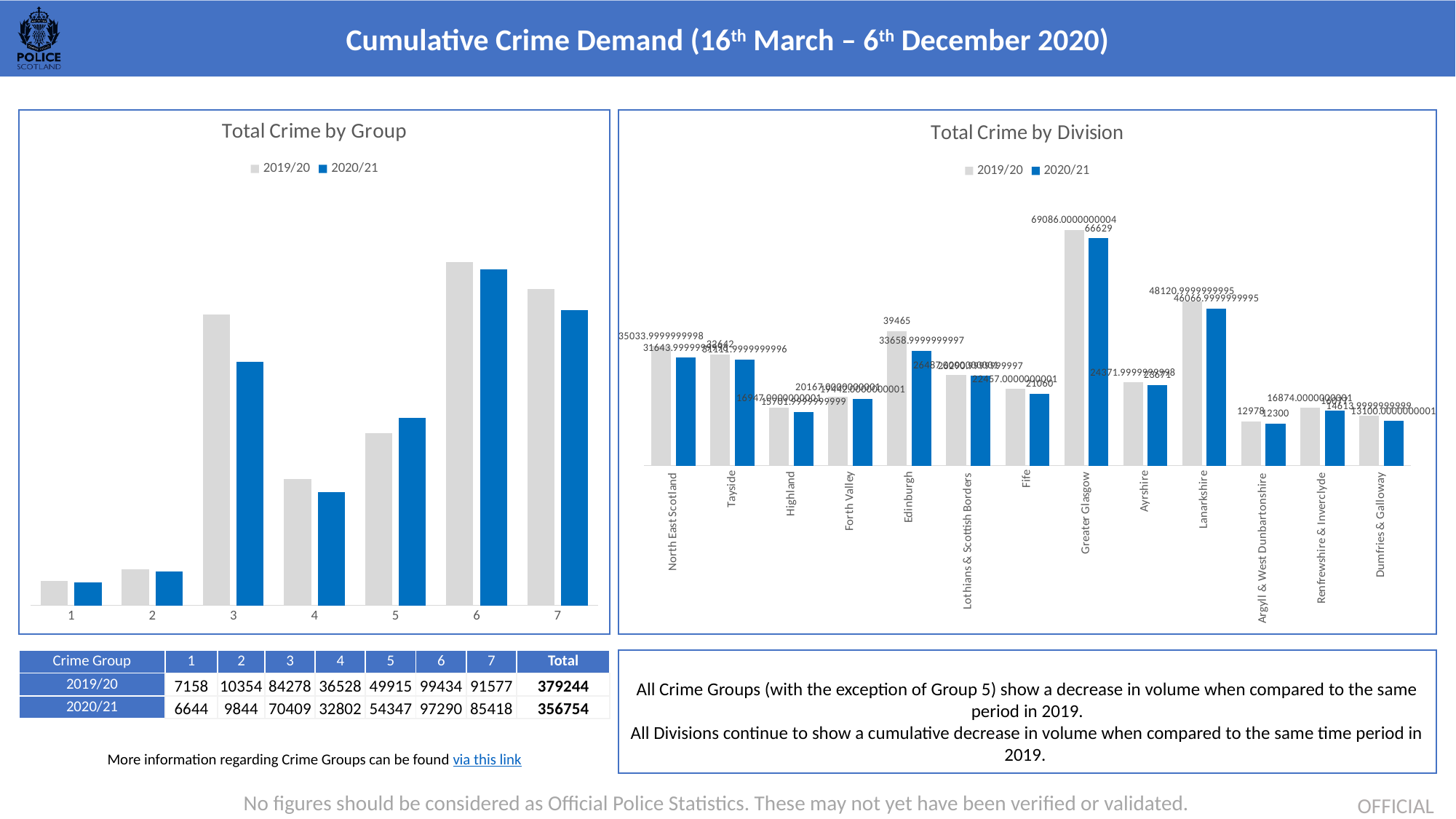
How many series does the legend of the Total Crime by Division chart list? 2 In the Total Crime by Group chart, how many crime groups are shown on the x axis? 7 In the Total Crime by Group chart, which crime group has the highest bars? 6 According to the slide, what is the 2019/20 value for crime group 3 in the Total Crime by Group chart? 84278 In the Total Crime by Division chart, which division has the lowest total crime? Argyll & West Dunbartonshire In the Total Crime by Division chart, which division has the highest total crime? Greater Glasgow In the Total Crime by Division chart, what is the 2019/20 value for Edinburgh? 39465 In the Total Crime by Group chart, which crime group has the lowest bars? 1 In the Total Crime by Group chart, which series is larger for crime group 5, 2019/20 or 2020/21? 2020/21 In the Total Crime by Division chart, how many divisions are shown on the x axis? 13 According to the slide, what is the difference between the 2020/21 and 2019/20 values for crime group 5? 4432 In the Total Crime by Division chart, what is the 2020/21 value for Greater Glasgow? 66629